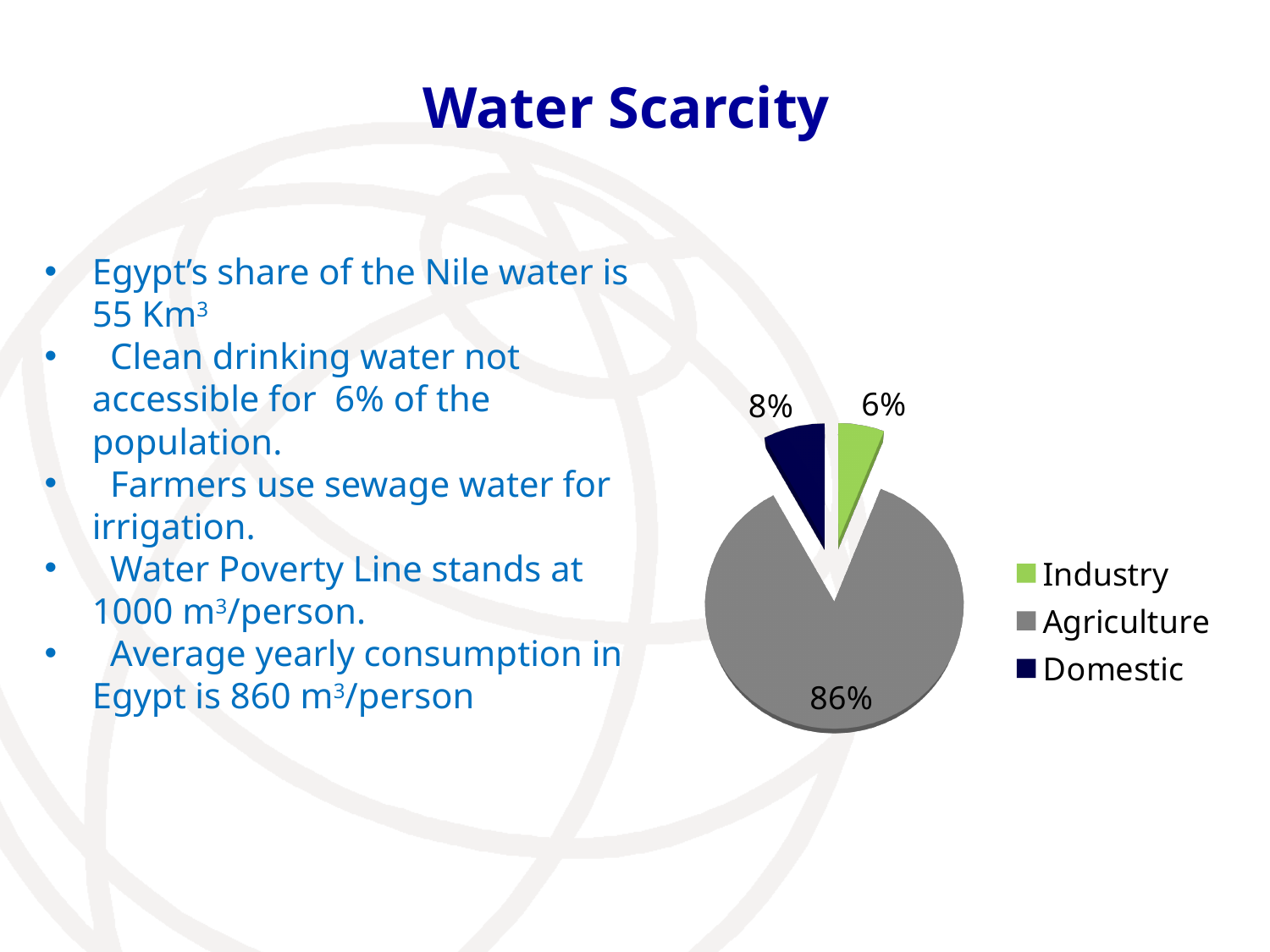
Which category has the smallest slice of the pie? Industry What colour is the Agriculture slice in the pie chart? grey Which category has the largest slice of the pie? Agriculture How many entries does the legend list? 3 What kind of chart is shown on the slide? pie chart Which legend entry is shown in green? Industry How many categories does the pie chart show? 3 What is the difference in percentage points between the Agriculture and Domestic slices? 78 What share of the pie does Agriculture account for? 86% Which slice is larger, Domestic or Industry? Domestic What share of the pie does Industry account for? 6% What share of the pie does Domestic account for? 8%